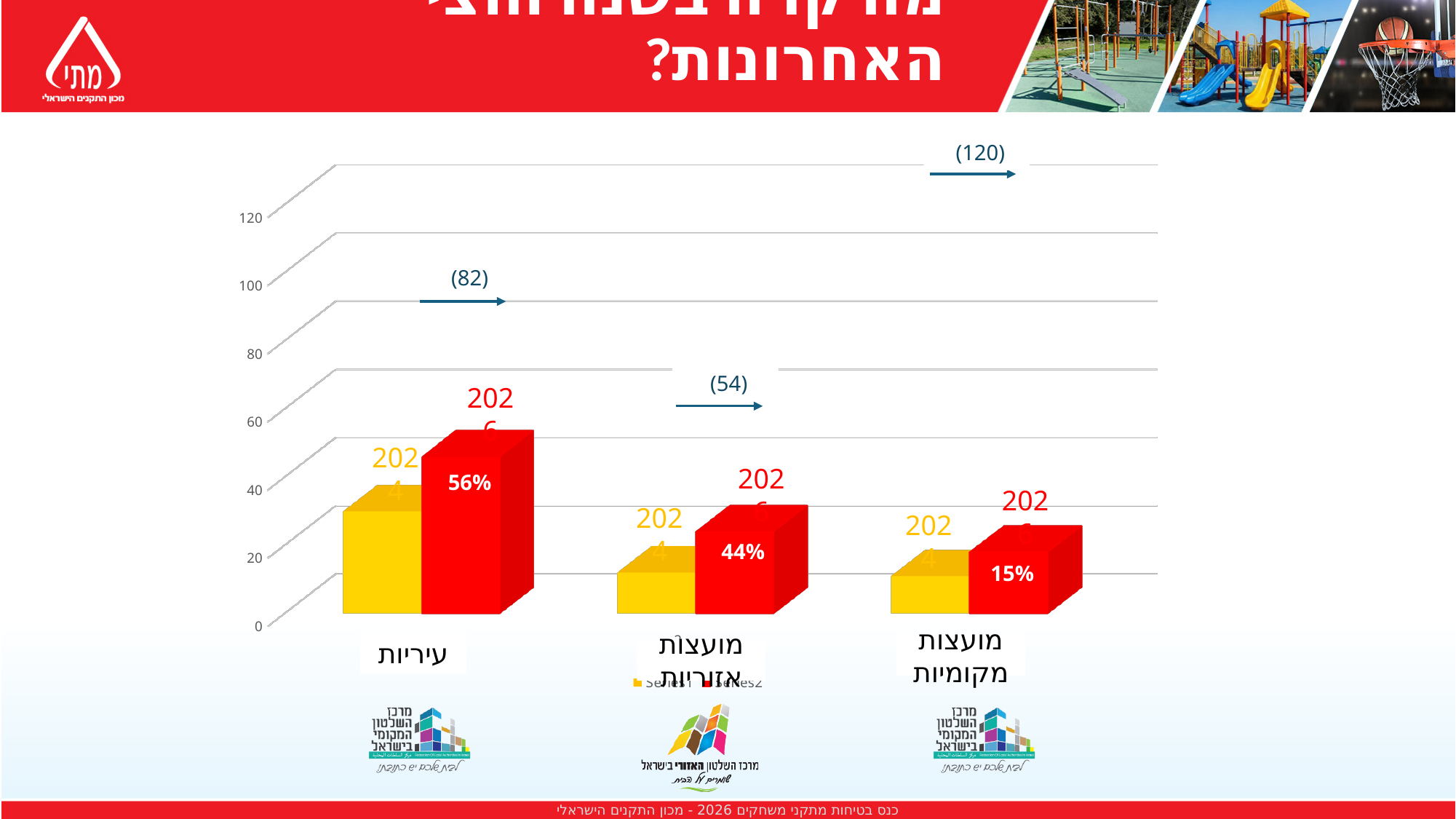
What is the 2026 value shown for מועצות מקומיות? 15% Which category has the lowest 2026 value? מועצות מקומיות How many series does the legend list? 2 Which category has the highest 2026 value? עיריות Which has the larger 2026 value, עיריות or מועצות מקומיות? עיריות What is the difference between the 2026 values for מועצות אזוריות and מועצות מקומיות? 29 percentage points What is the 2026 value shown for מועצות אזוריות? 44% Is the 2024 (yellow) bar for עיריות greater or less than 40? less What is the 2026 value shown for עיריות? 56% What is the difference between the 2026 values for עיריות and מועצות אזוריות? 12 percentage points How many categories are shown on the x axis? 3 What kind of chart is shown on the slide? bar chart